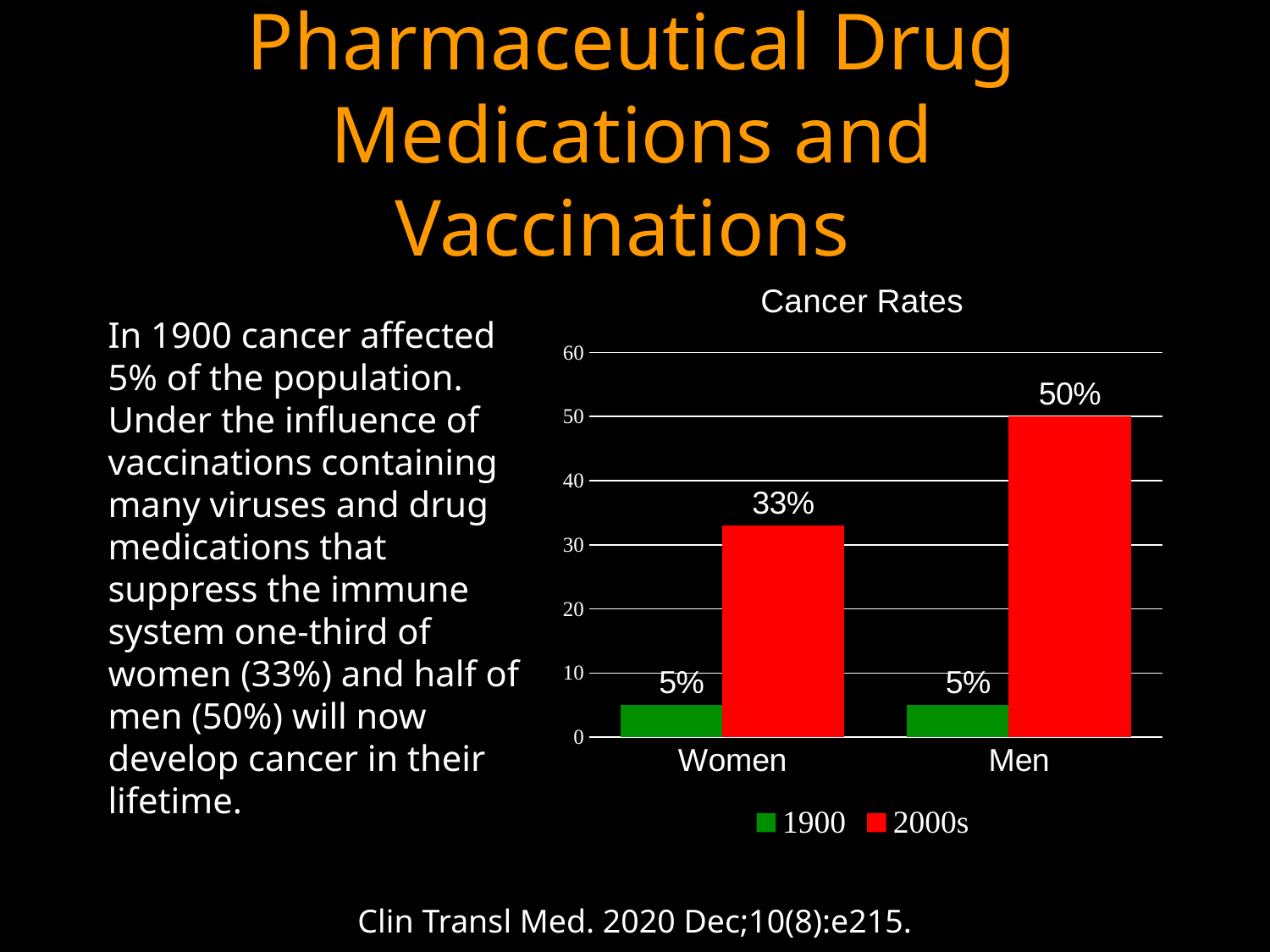
What is the title of the chart? Cancer Rates Which category has the highest 2000s cancer rate? Men What is the cancer rate for Women in 1900? 5% What is the cancer rate for Men in the 2000s? 50% How many categories are shown on the x axis? 2 What is the cancer rate for Women in the 2000s? 33% How many series does the legend list? 2 Is the 2000s value for Women greater or less than 40? less What kind of chart is shown? bar chart What is the difference between the 2000s and 1900 cancer rates for Men? 45% Which is larger, the 2000s cancer rate for Women or for Men? Men What is the difference between the 2000s cancer rate for Men and for Women? 17%